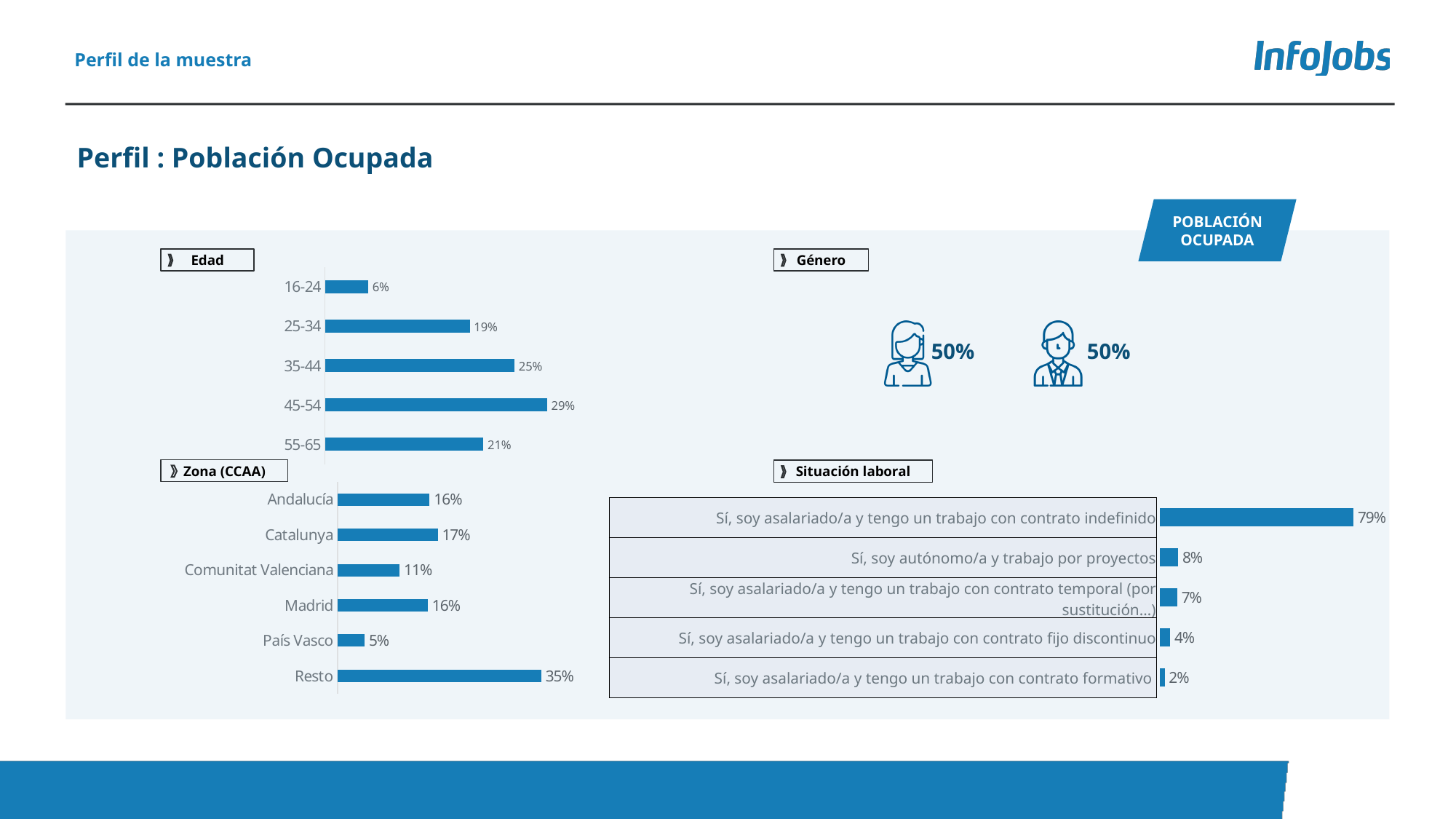
In the Zona (CCAA) chart, what is the value for Comunitat Valenciana? 11% In the Zona (CCAA) chart, which is larger, Catalunya or Madrid? Catalunya What type of chart is the Edad chart? Bar chart In the Situación laboral chart, what is the difference between the contrato fijo discontinuo and contrato formativo categories? 2% In the Situación laboral chart, which category has the highest value? Sí, soy asalariado/a y tengo un trabajo con contrato indefinido In the Zona (CCAA) chart, how many categories are shown? 6 In the Edad chart, what is the difference between the 35-44 and 25-34 age groups? 6% In the Edad chart, which age group has the lowest value? 16-24 In the Situación laboral chart, what is the value for 'Sí, soy autónomo/a y trabajo por proyectos'? 8% In the Edad chart, what is the value for the 45-54 age group? 29% In the Zona (CCAA) chart, which category has the highest value? Resto In the Edad chart, how many age groups are shown? 5